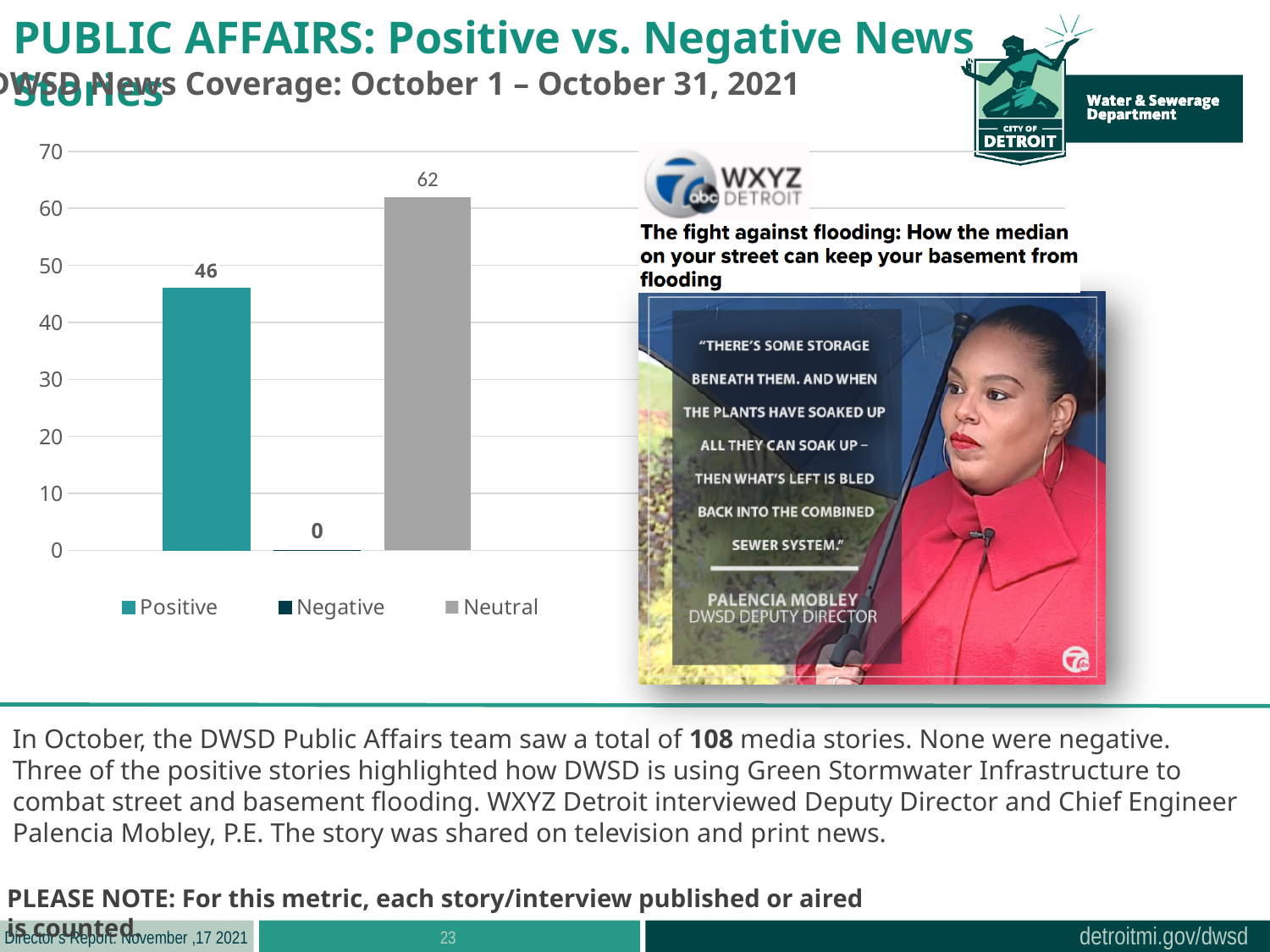
What is the value for Positive news stories? 46 How many entries does the chart legend list? 3 Is the value for Positive greater or less than 50? less How many categories are shown in the chart? 3 Which category has the lowest value? Negative Which category has the highest value? Neutral What is the value for Negative news stories? 0 What kind of chart is shown on the slide? bar chart What is the total of the Positive, Negative and Neutral values? 108 What is the difference between the Neutral and Positive values? 16 Which is larger, the Positive value or the Neutral value? Neutral What is the value for Neutral news stories? 62